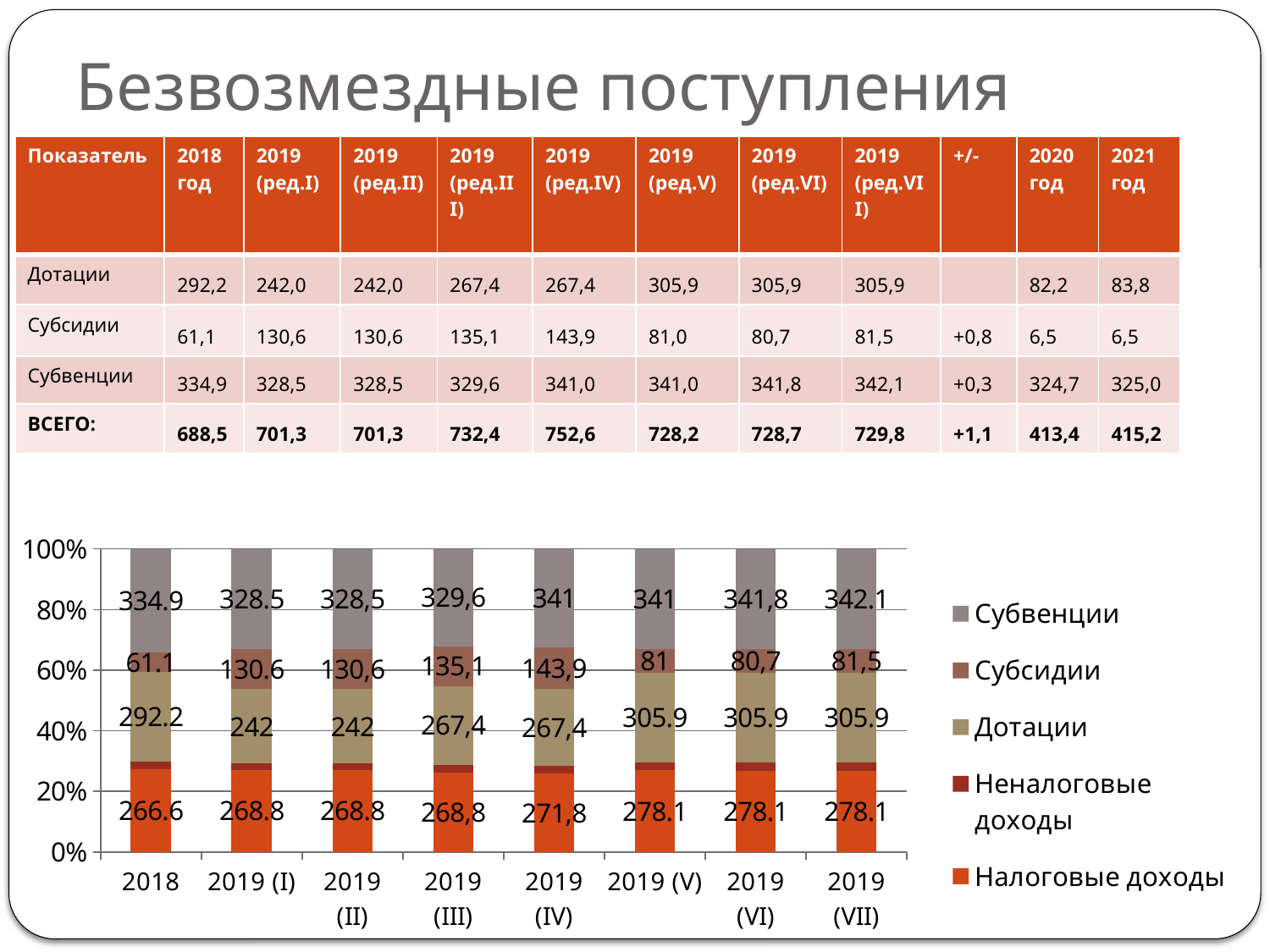
What is the data label for Налоговые доходы in the 2019 (V) bar of the chart? 278.1 What is the difference between the Субсидии labels for 2019 (IV) and 2019 (V) in the chart? 62,9 How many categories are shown along the x axis of the chart? 8 In which category does Дотации have its lowest labelled value in the chart? 2019 (I) and 2019 (II) Which series is shown in grey at the top of each bar in the chart? Субвенции What is the data label for Субвенции in the 2018 bar of the chart? 334.9 Which is larger in the chart: the Дотации label for 2018 or for 2019 (VII)? 2019 (VII) In which category does Субсидии have its highest labelled value in the chart? 2019 (IV) What is the data label for Субсидии in the 2019 (IV) bar of the chart? 143,9 How many series does the chart legend list? 5 What kind of chart is shown on the slide? Stacked bar chart What is the data label for Дотации in the 2019 (III) bar of the chart? 267,4